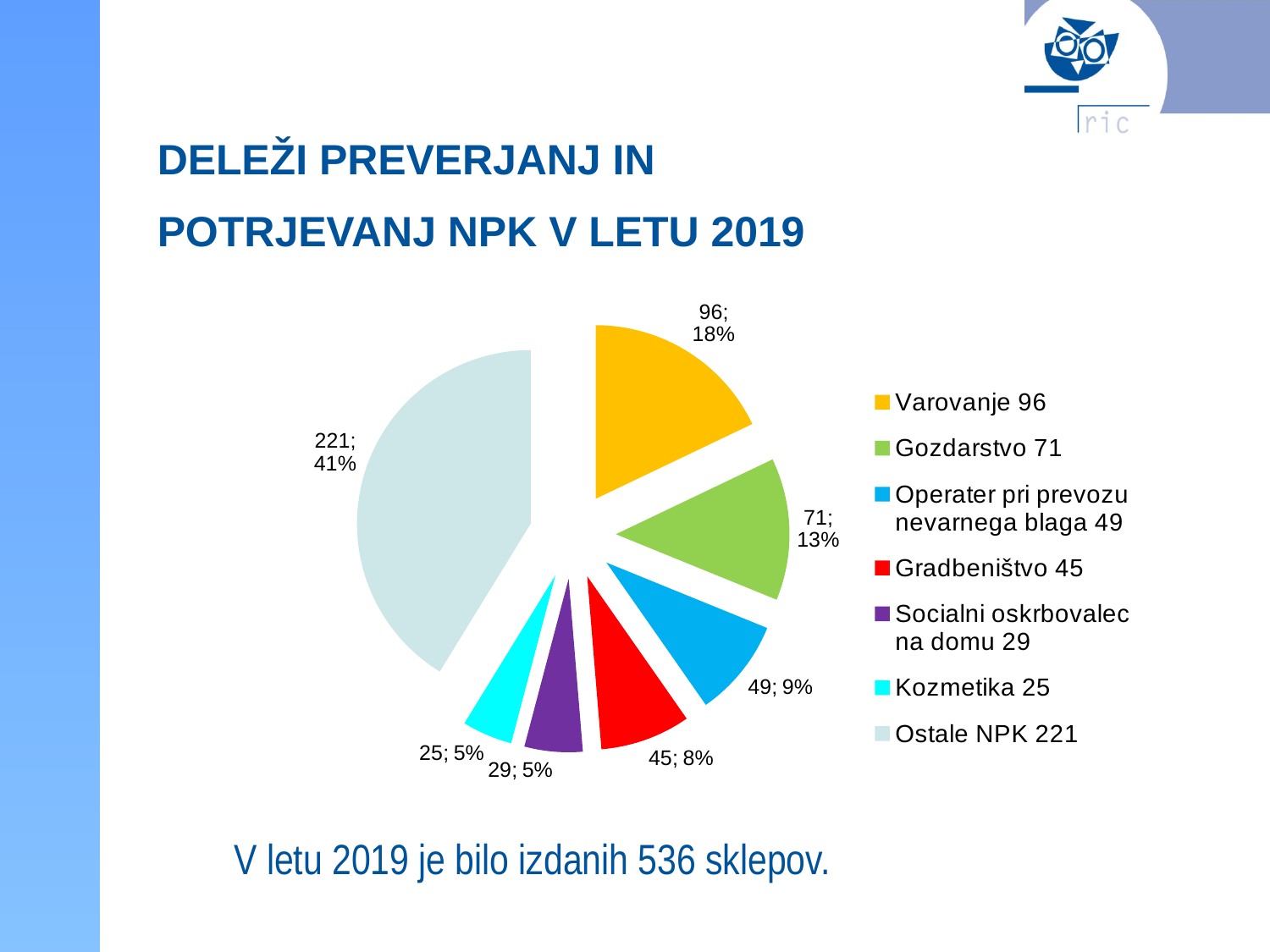
Which slice of the pie chart is the smallest? Kozmetika 25 What percentage share does the Ostale NPK 221 slice have? 41% What percentage share does the Gradbeništvo 45 slice have? 8% What value is shown for Varovanje 96 in the pie chart? 96; 18% What colour is the Ostale NPK 221 slice? light grey-blue Which is larger, the value for Operater pri prevozu nevarnega blaga 49 or Socialni oskrbovalec na domu 29? Operater pri prevozu nevarnega blaga 49 What is the difference between the values for Varovanje 96 and Gradbeništvo 45? 51 How many slices does the pie chart have? 7 Which slice of the pie chart is the largest? Ostale NPK 221 What percentage share does the Gozdarstvo 71 slice have? 13% How many entries does the legend list? 7 What kind of chart is shown on the slide? pie chart